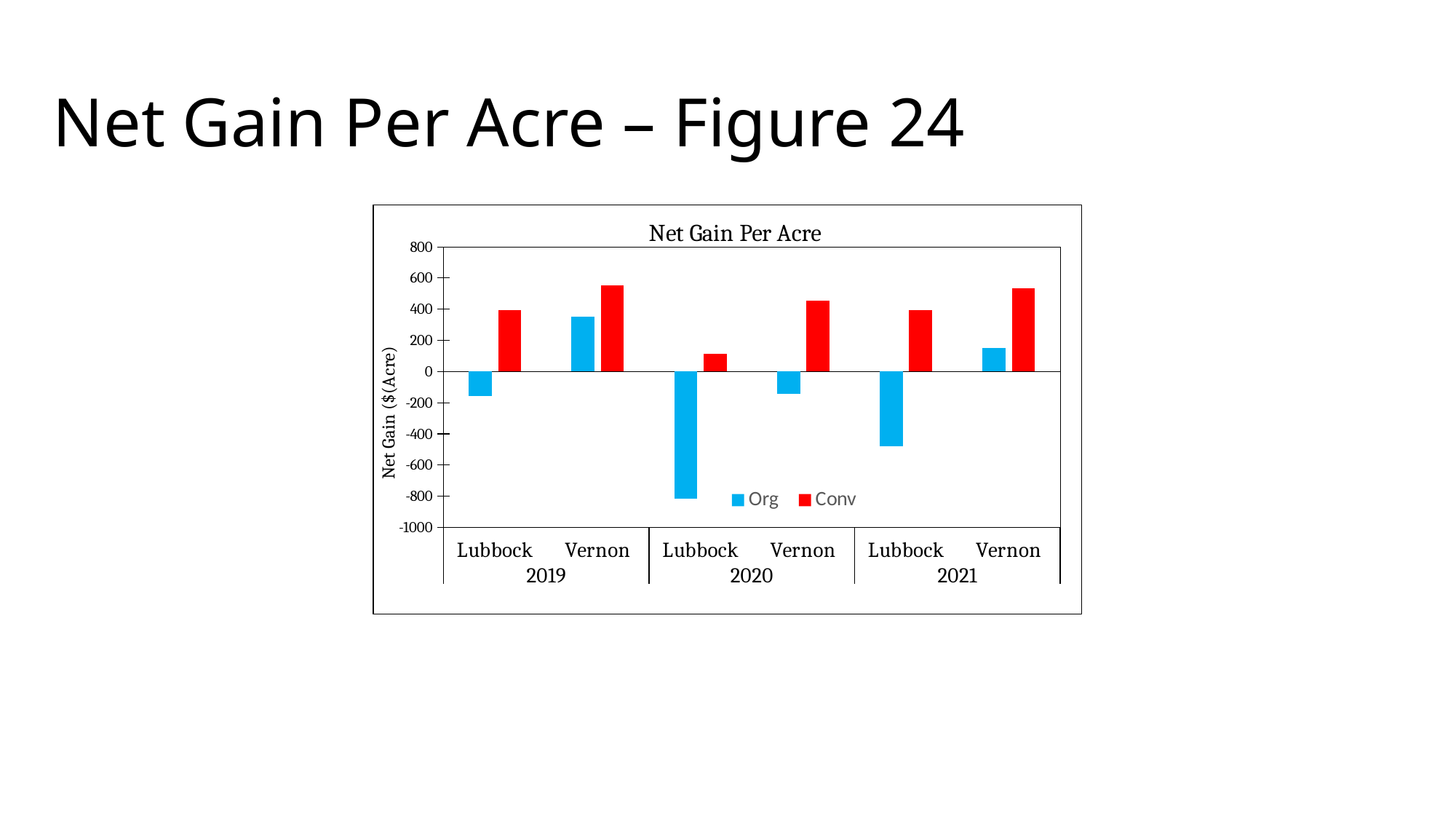
Is the Org value for Lubbock in 2020 greater or less than -600? less How many series does the legend list? 2 What kind of chart is shown on the slide? bar chart Which is larger for Vernon in 2021, the Org value or the Conv value? Conv Which location and year has the highest Org value? Vernon 2019 Which series is shown in red? Conv Which location and year has the lowest Org value? Lubbock 2020 Is the Conv value for Lubbock in 2020 greater or less than 200? less Is the Conv value for Vernon in 2019 greater or less than 400? greater Which location and year has the lowest Conv value? Lubbock 2020 How many location-year categories are shown on the x axis? 6 What is the y-axis title of the chart? Net Gain ($/Acre)